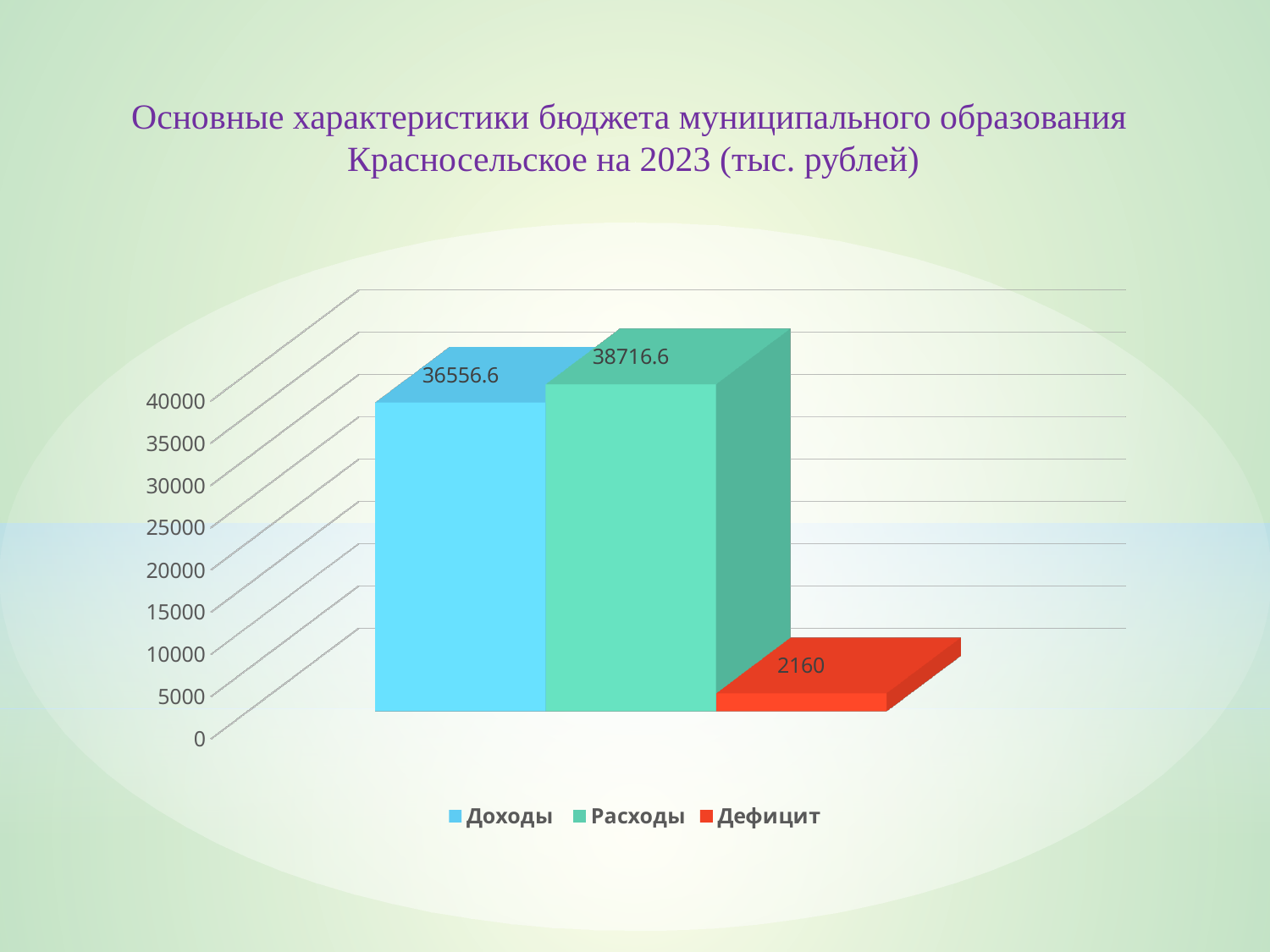
Is the value for Дефицит greater or less than 5000? less How many series does the legend list? 3 Which is larger, Доходы or Расходы? Расходы What colour is the bar for Дефицит? red What is the value for Доходы? 36556.6 Which series has the lowest value? Дефицит What is the difference between Доходы and Дефицит? 34396.6 What kind of chart is shown on the slide? bar chart What is the value for Дефицит? 2160 Which series has the highest value? Расходы What is the value for Расходы? 38716.6 What is the difference between Расходы and Доходы? 2160